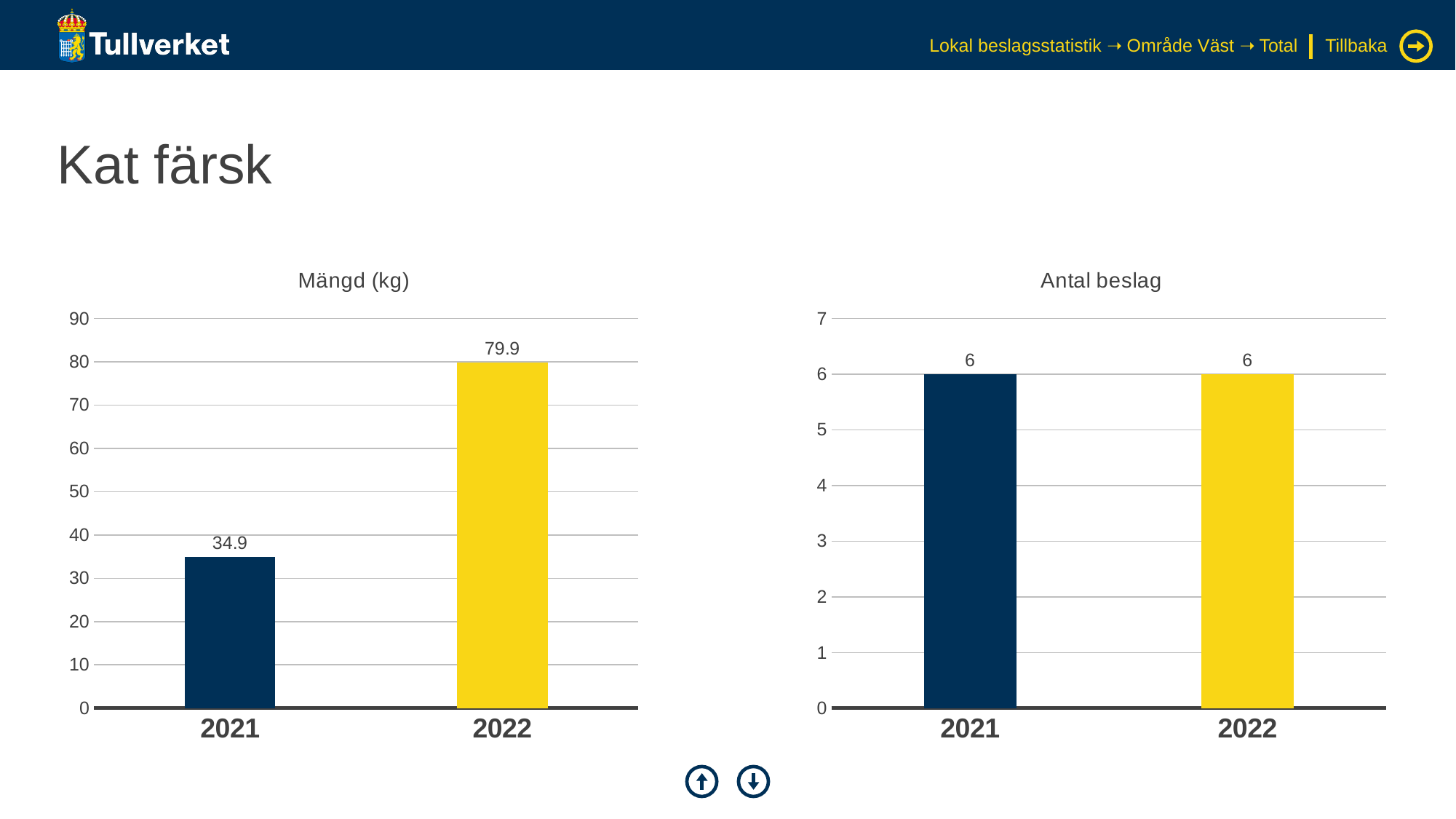
What kind of chart is the 'Mängd (kg)' chart? bar chart In the 'Mängd (kg)' chart, what is the difference between the 2022 and 2021 values? 45.0 In the 'Mängd (kg)' chart, which year has the highest value? 2022 In the 'Antal beslag' chart, what is the value for 2022? 6 In the 'Antal beslag' chart, what is the difference between the 2021 and 2022 values? 0 In the 'Mängd (kg)' chart, what is the value for 2022? 79.9 In the 'Mängd (kg)' chart, is the value for 2022 greater or less than 70? greater In the 'Antal beslag' chart, what is the value for 2021? 6 In the 'Mängd (kg)' chart, which year has the lowest value? 2021 How many years are shown in the 'Antal beslag' chart? 2 In the 'Mängd (kg)' chart, what is the value for 2021? 34.9 In the 'Mängd (kg)' chart, do the values rise or fall from 2021 to 2022? rise